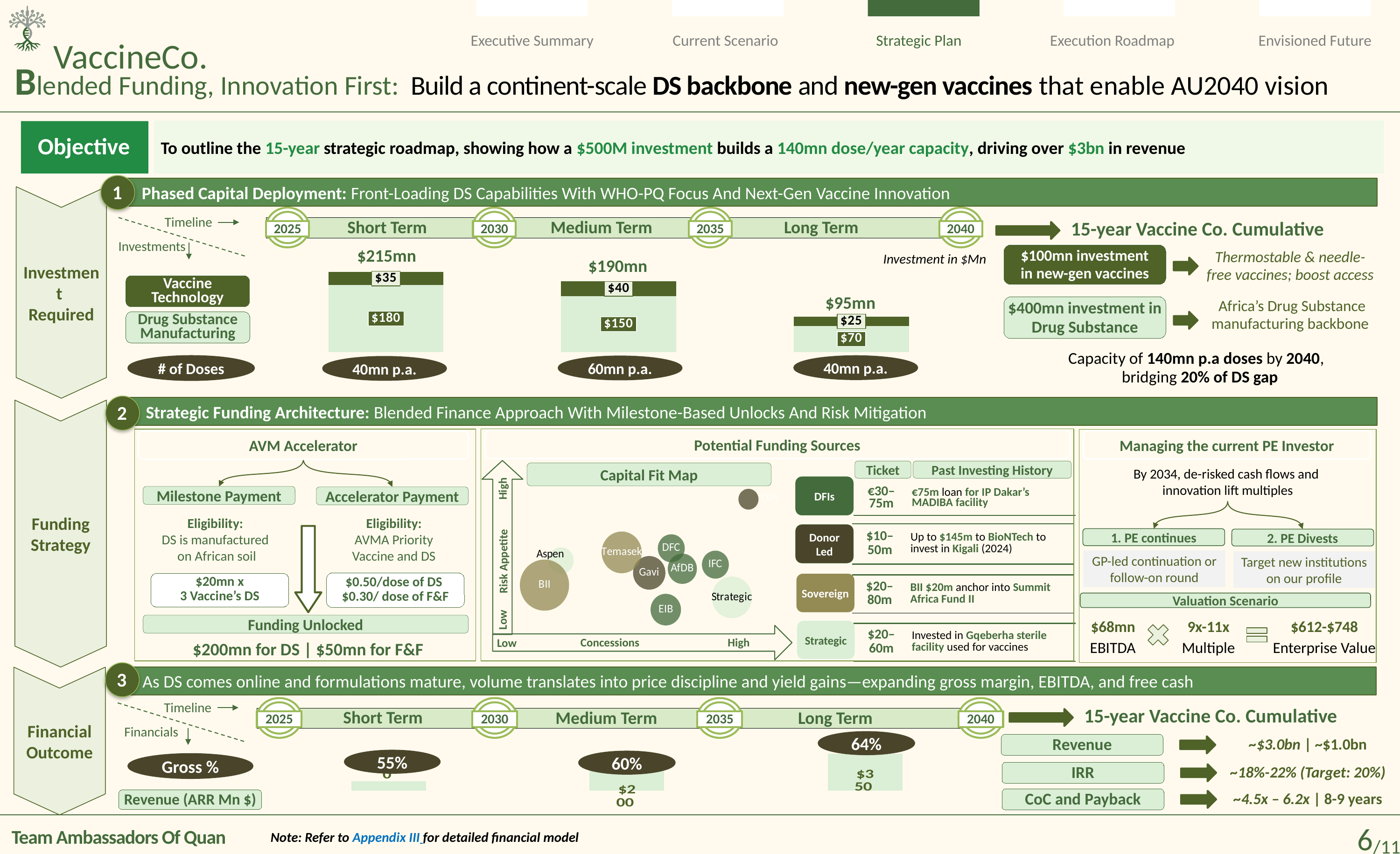
What type of chart is the Capital Fit Map under Potential Funding Sources? Bubble chart In the Investment Required stacked bar chart, what is the Vaccine Technology value for the Long Term period? $25 In the Investment Required stacked bar chart, which period has the lowest total investment? Long Term In the Investment Required stacked bar chart, is the Vaccine Technology value larger in the Short Term or the Medium Term period? Medium Term In the Capital Fit Map bubble chart, what is the label of the vertical axis? Risk Appetite In the Investment Required stacked bar chart, do the total investments rise or fall from Short Term to Long Term? Fall In the Investment Required stacked bar chart, what is the difference between the Short Term and Medium Term total investments? $25mn In the Financial Outcome section, what is the Gross % shown for the Long Term period? 64% In the Investment Required stacked bar chart, what is the Drug Substance Manufacturing value for the Medium Term period? $150 In the Investment Required stacked bar chart, which period has the highest total investment? Short Term In the Investment Required stacked bar chart, what is the total investment shown for the Short Term period? $215mn In the Investment Required stacked bar chart, how many time periods (bars) are shown? 3